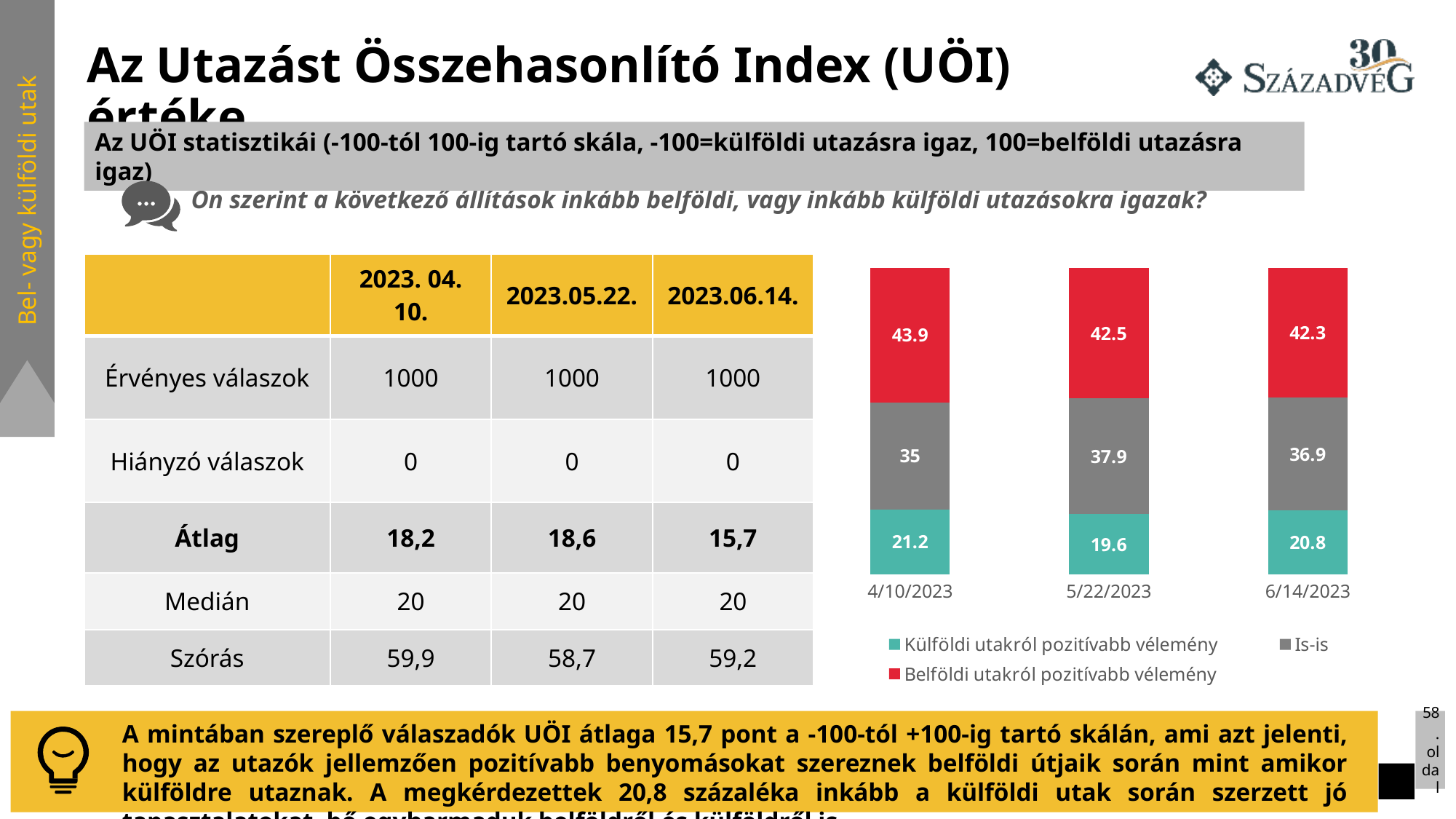
What is the value of 'Is-is' for 5/22/2023? 37.9 What kind of chart is shown on the right side of the slide? stacked bar chart What is the difference between the 'Is-is' values for 5/22/2023 and 4/10/2023? 2.9 On which date is the 'Belföldi utakról pozitívabb vélemény' value the highest? 4/10/2023 Which colour represents 'Belföldi utakról pozitívabb vélemény' in the chart? red How many dates (bars) are shown on the chart's x axis? 3 Which is larger for 6/14/2023: 'Is-is' or 'Külföldi utakról pozitívabb vélemény'? Is-is What is the value of 'Belföldi utakról pozitívabb vélemény' for 4/10/2023? 43.9 How many series does the chart legend list? 3 On which date is the 'Is-is' value the lowest? 4/10/2023 What is the value of 'Külföldi utakról pozitívabb vélemény' for 6/14/2023? 20.8 What is the total of the stacked bar for 5/22/2023? 100